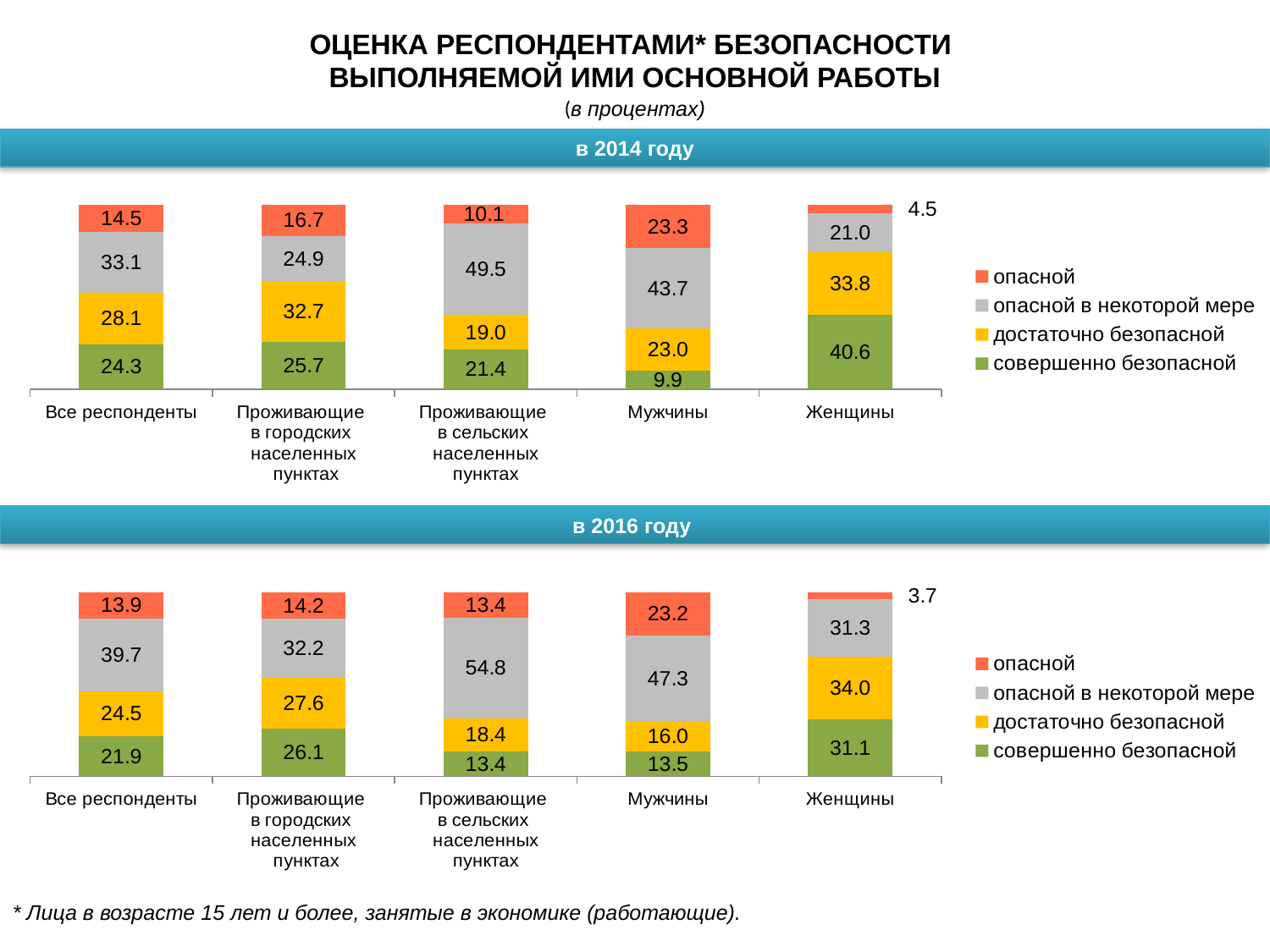
In the chart 'в 2016 году', which is larger: 'достаточно безопасной' for Женщины or for Мужчины? Женщины What type of chart is 'в 2016 году'? Stacked bar chart In the chart 'в 2014 году', what is the value of 'совершенно безопасной' for Женщины? 40.6 In the chart 'в 2014 году', which category has the lowest value for 'совершенно безопасной'? Мужчины How many categories are shown on the x axis of the chart 'в 2016 году'? 5 In the chart 'в 2014 году', what is the difference between the 'опасной' values for Мужчины and Женщины? 18.8 How many series does the legend of the chart 'в 2014 году' list? 4 In the chart 'в 2016 году', which category has the lowest value for 'опасной'? Женщины In the chart 'в 2014 году', what is the total of the stacked bar for Все респонденты? 100.0 In the chart 'в 2016 году', what is the value of 'опасной в некоторой мере' for Проживающие в сельских населенных пунктах? 54.8 In the chart 'в 2014 году', which category has the highest value for 'совершенно безопасной'? Женщины In the chart 'в 2016 году', what is the difference between the 'опасной в некоторой мере' values for Проживающие в сельских населенных пунктах and Проживающие в городских населенных пунктах? 22.6